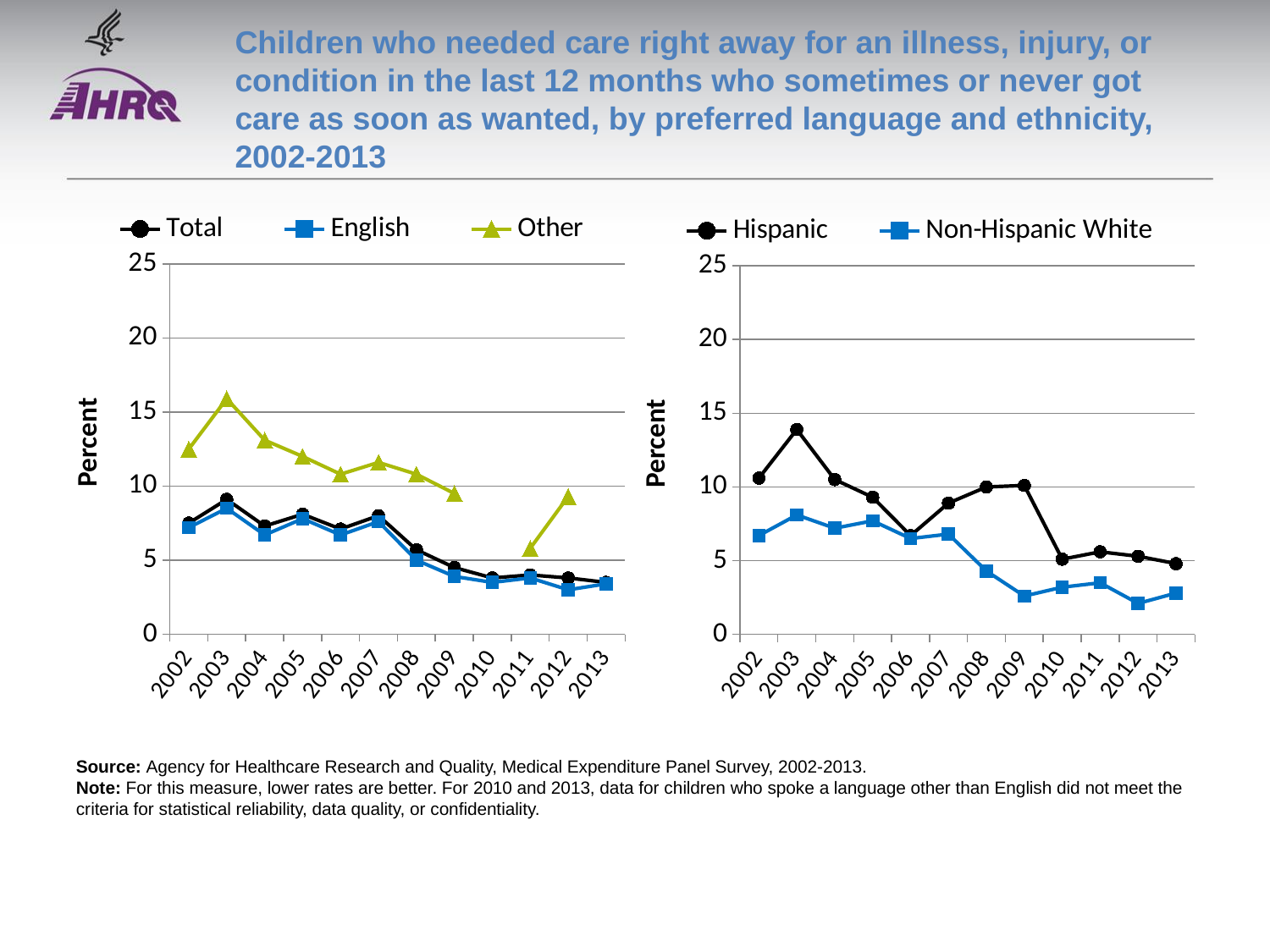
In the left chart, which is larger in 2005, Other or English? Other In the left chart, in which year is the value for Other highest? 2003 In the left chart, is the value for Total in 2013 greater or less than 5? less What kind of chart is the left chart (Total, English, Other)? line chart In the right chart, which is larger in 2008, Hispanic or Non-Hispanic White? Hispanic In the left chart, does the Total series generally rise or fall from 2002 to 2013? fall How many series does the legend of the left chart list? 3 In the left chart, is the value for Other in 2003 greater or less than 15? greater How many series does the legend of the right chart list? 2 How many years are shown on the x axis of the right chart (Hispanic, Non-Hispanic White)? 12 In the right chart, in which year is the value for Hispanic highest? 2003 In the right chart, is the value for Non-Hispanic White in 2012 greater or less than 5? less